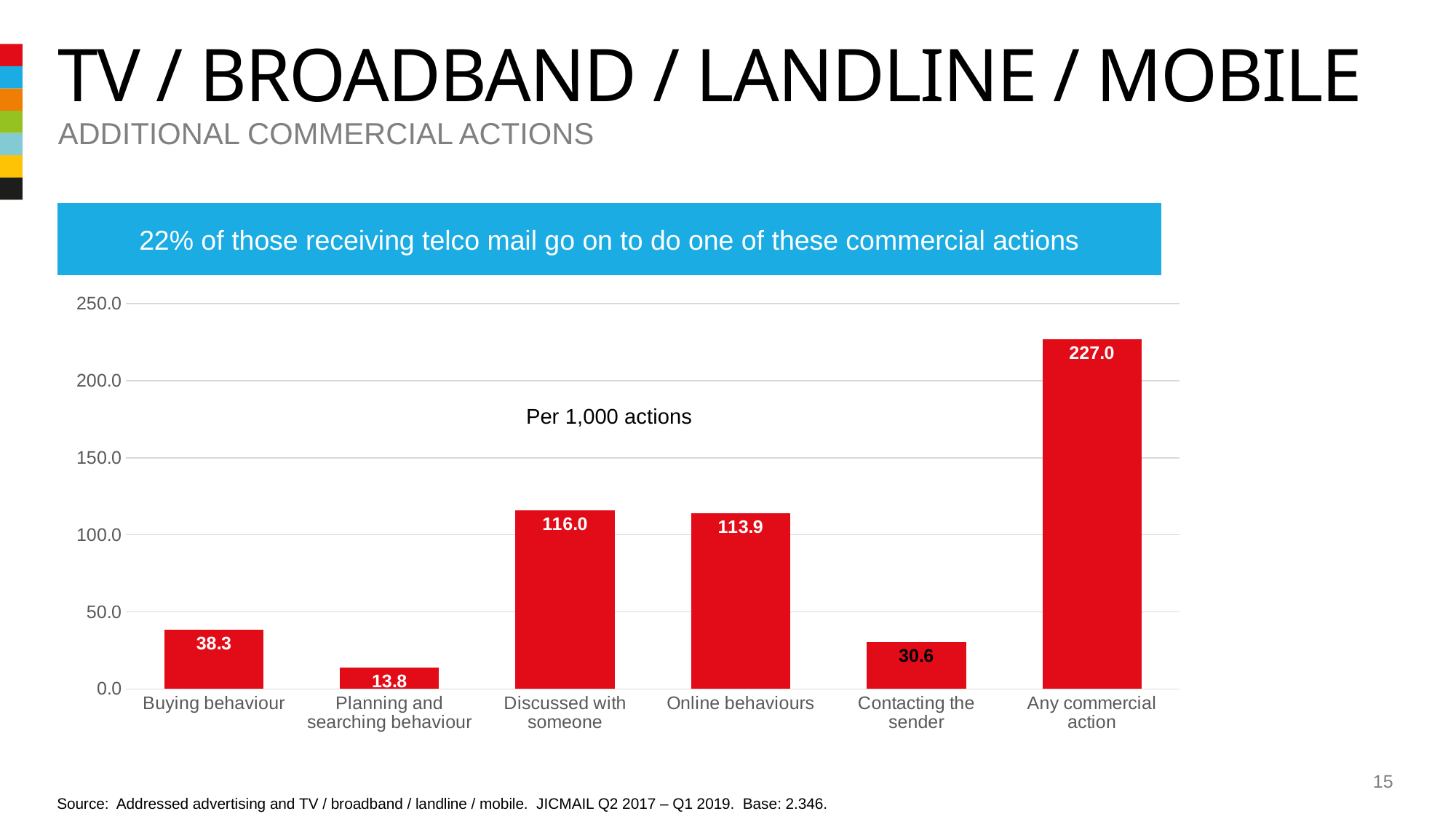
Which category has the lowest value? Planning and searching behaviour What is the value for Planning and searching behaviour? 13.8 Which is larger, Buying behaviour or Contacting the sender? Buying behaviour Which category has the highest value? Any commercial action What is the value for Any commercial action? 227.0 What kind of chart is shown on the slide? bar chart What is the value for Buying behaviour? 38.3 What is the difference between Discussed with someone and Online behaviours? 2.1 How many categories are shown on the x axis? 6 Is the value for Online behaviours greater or less than 100.0? greater What is the value for Contacting the sender? 30.6 What unit label is printed inside the chart area? Per 1,000 actions